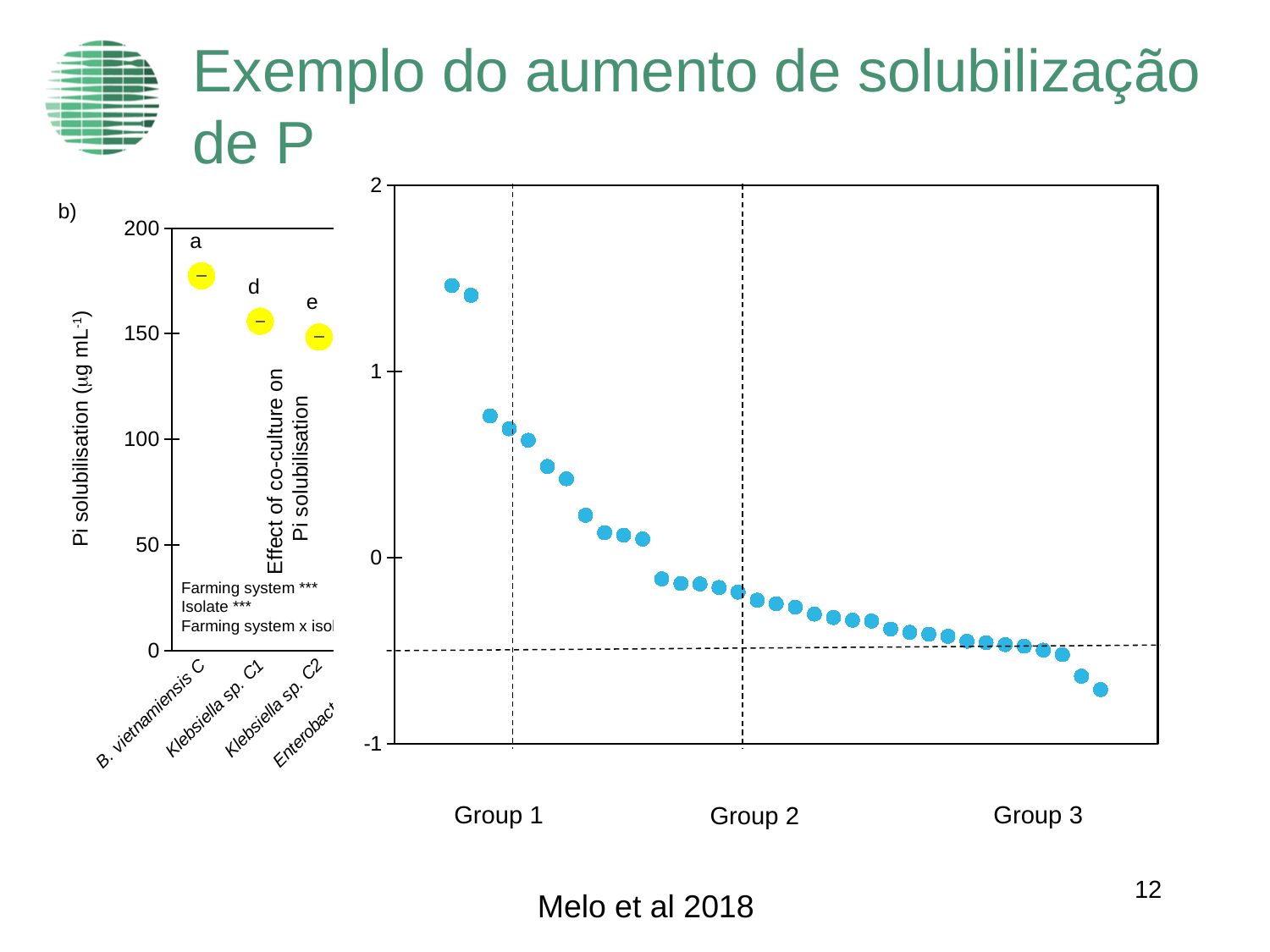
What kind of chart is the large chart on the right of the slide? scatter chart What is the y-axis label of the left chart (b)? Pi solubilisation (µg mL-1) In the chart on the right, do the plotted values rise or fall from left to right along the x axis? fall In the left chart (b), which of the three plotted isolates has the highest Pi solubilisation? B. vietnamiensis C In the left chart (b), is the value for Klebsiella sp. C1 greater or less than 100? greater In the chart on the right, is the lowest plotted point greater or less than 0? less How many group labels are shown along the x axis of the chart on the right? 3 In the chart on the right, which group label contains the highest plotted values? Group 1 In the left chart (b), which is larger, the value for B. vietnamiensis C or the value for Klebsiella sp. C2? B. vietnamiensis C In the chart on the right, is the highest plotted point greater or less than 1? greater In the chart on the right, which group label contains the lowest plotted values? Group 3